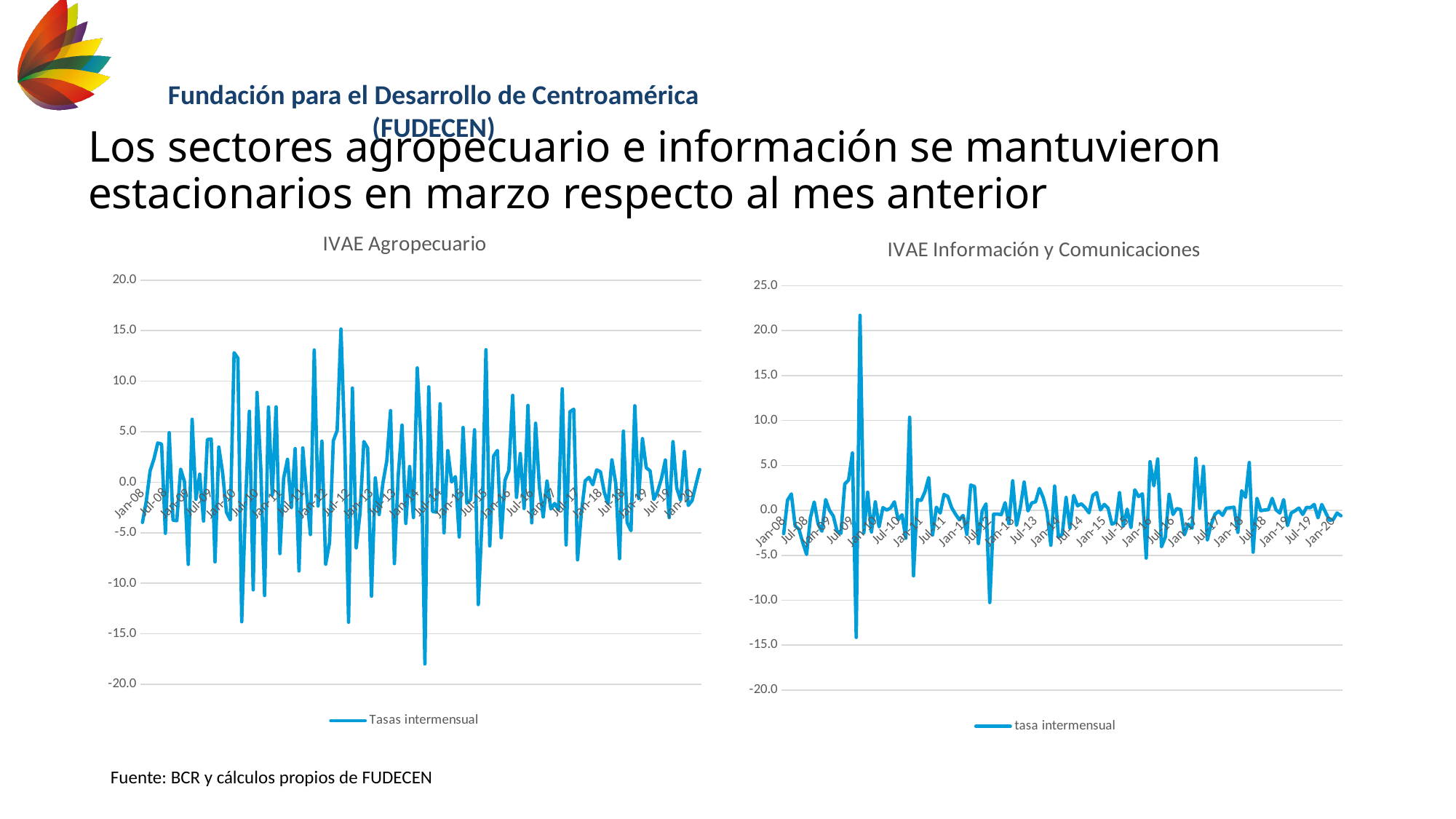
What kind of chart is the 'IVAE Agropecuario' chart? line chart How many series does the legend of the 'IVAE Información y Comunicaciones' chart list? 1 In the 'IVAE Información y Comunicaciones' chart, is the lowest point of the line greater or less than -10.0? less In the 'IVAE Agropecuario' chart, is the lowest point of the line greater or less than -15.0? less Which chart reaches a higher maximum value, 'IVAE Agropecuario' or 'IVAE Información y Comunicaciones'? IVAE Información y Comunicaciones What is the legend entry of the 'IVAE Agropecuario' chart? Tasas intermensual In the 'IVAE Información y Comunicaciones' chart, is the highest peak of the line greater or less than 20.0? greater What is the title of the chart on the right side of the slide? IVAE Información y Comunicaciones How many series does the legend of the 'IVAE Agropecuario' chart list? 1 What kind of chart is the 'IVAE Información y Comunicaciones' chart? line chart What is the highest value shown on the y-axis of the 'IVAE Información y Comunicaciones' chart? 25.0